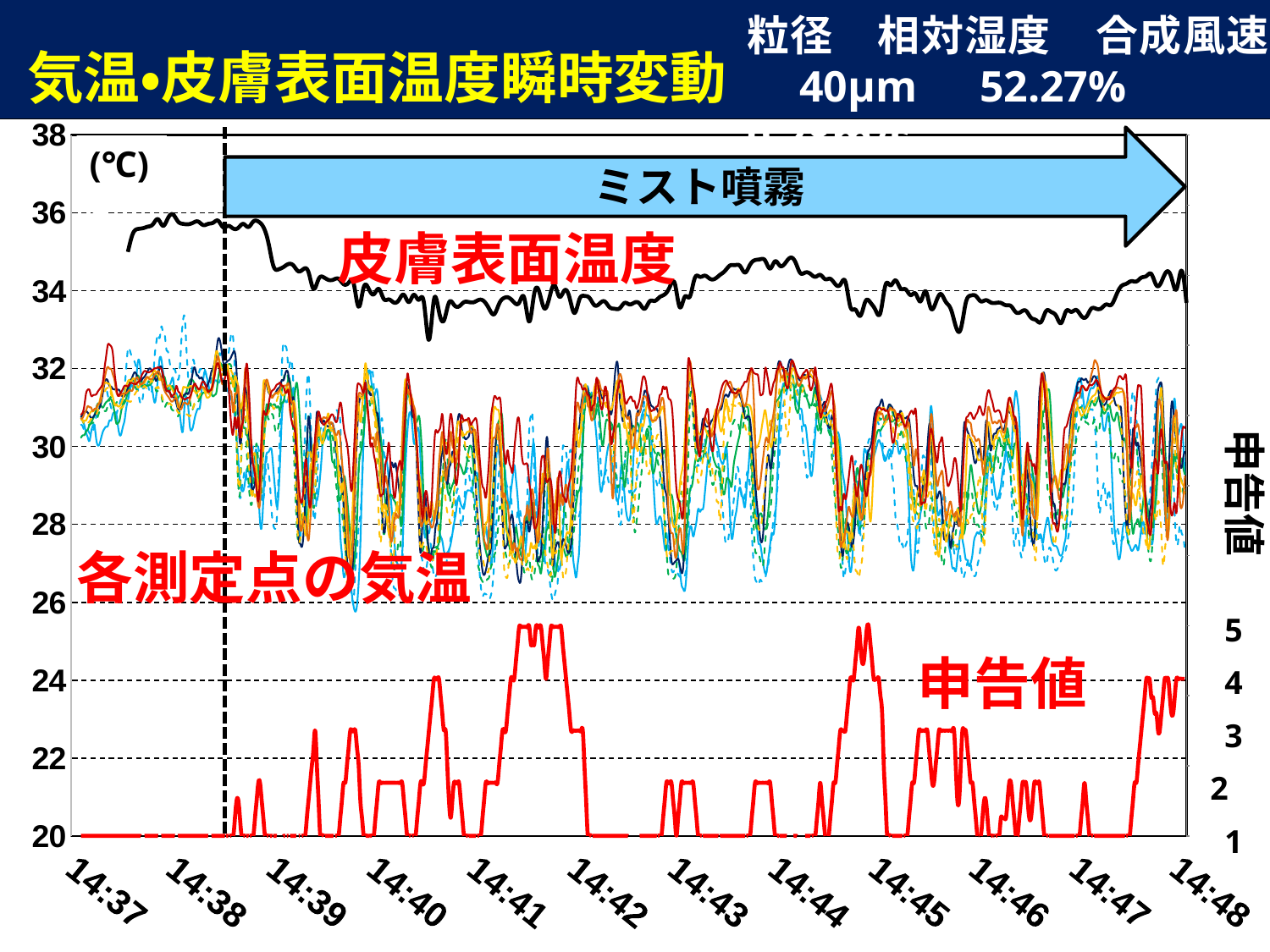
What kind of chart is shown on the slide? line chart What is the unit shown for the left y axis? ℃ Does the 皮膚表面温度 line rise or fall after the mist spraying (ミスト噴霧) begins at around 14:38? fall Is the 皮膚表面温度 value at 14:40 greater or less than 36? less Is the 皮膚表面温度 value at 14:37 greater or less than 34? greater Are the 各測定点の気温 values at 14:37 greater or less than 28? greater What label is written on the blue arrow across the top of the chart? ミスト噴霧 What is the highest value reached by the 申告値 line on the right axis? 5 What is the lowest value of the 申告値 line on the right axis? 1 What is the title of the chart? 気温•皮膚表面温度瞬時変動 How many time labels are shown along the x axis? 12 At 14:40, which is higher: the 皮膚表面温度 line or the 各測定点の気温 lines? 皮膚表面温度